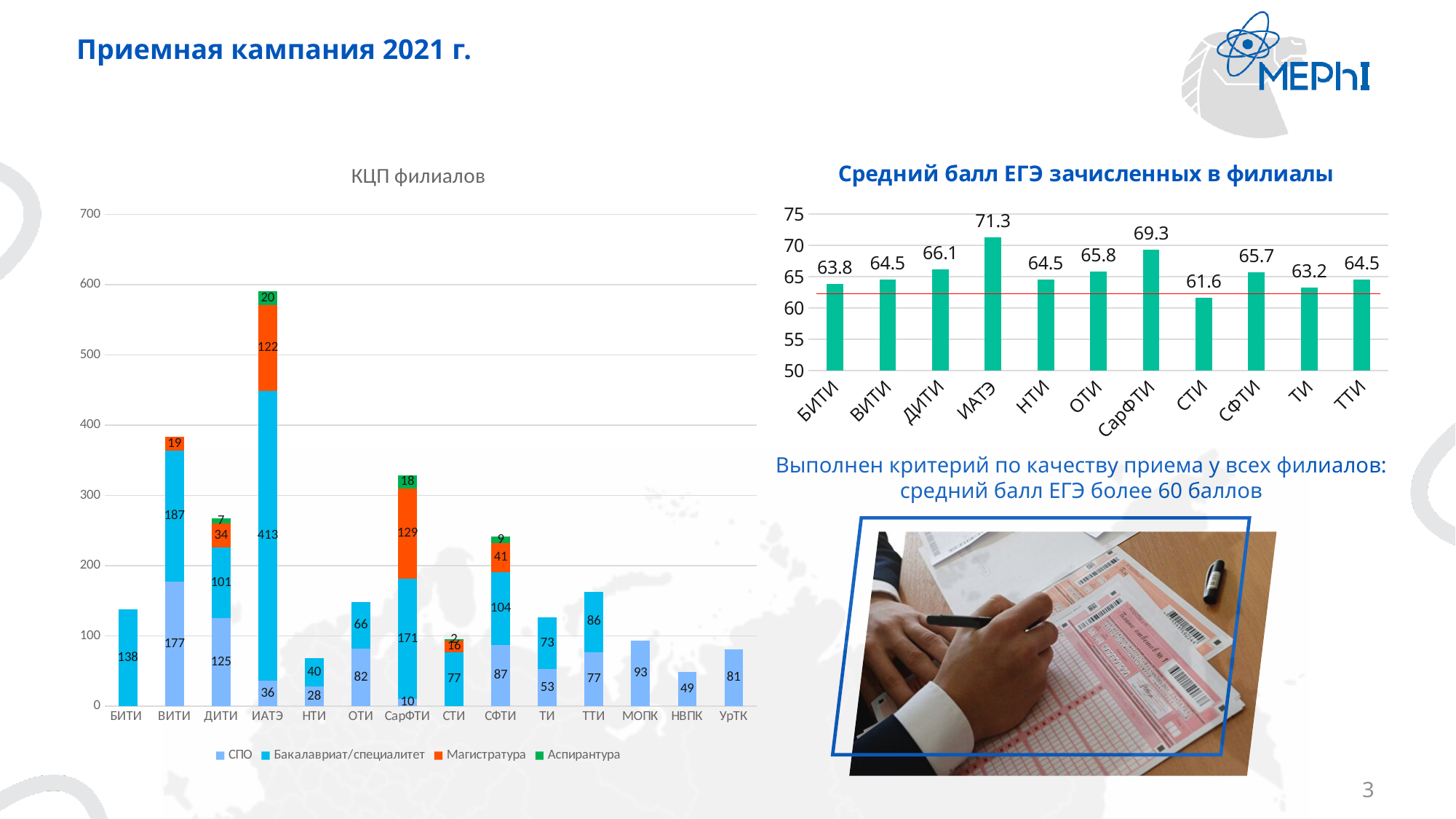
What kind of chart is 'Средний балл ЕГЭ зачисленных в филиалы'? Bar chart In the chart 'КЦП филиалов', what is the total of the stacked bar for ИАТЭ? 591 In the chart 'Средний балл ЕГЭ зачисленных в филиалы', which branch has the highest average score? ИАТЭ In the chart 'КЦП филиалов', which series is shown in orange? Магистратура In the chart 'Средний балл ЕГЭ зачисленных в филиалы', which branch has the lowest average score? СТИ In the chart 'КЦП филиалов', what is the value of Бакалавриат/специалитет for ИАТЭ? 413 In the chart 'Средний балл ЕГЭ зачисленных в филиалы', what is the value for СарФТИ? 69.3 In the chart 'КЦП филиалов', how many branches (categories) are shown on the x axis? 14 In the chart 'КЦП филиалов', what is the value of СПО for ВИТИ? 177 In the chart 'Средний балл ЕГЭ зачисленных в филиалы', what is the difference between the values for ИАТЭ and СТИ? 9.7 In the chart 'КЦП филиалов', what is the value of Магистратура for СарФТИ? 129 In the chart 'КЦП филиалов', how many series does the legend list? 4